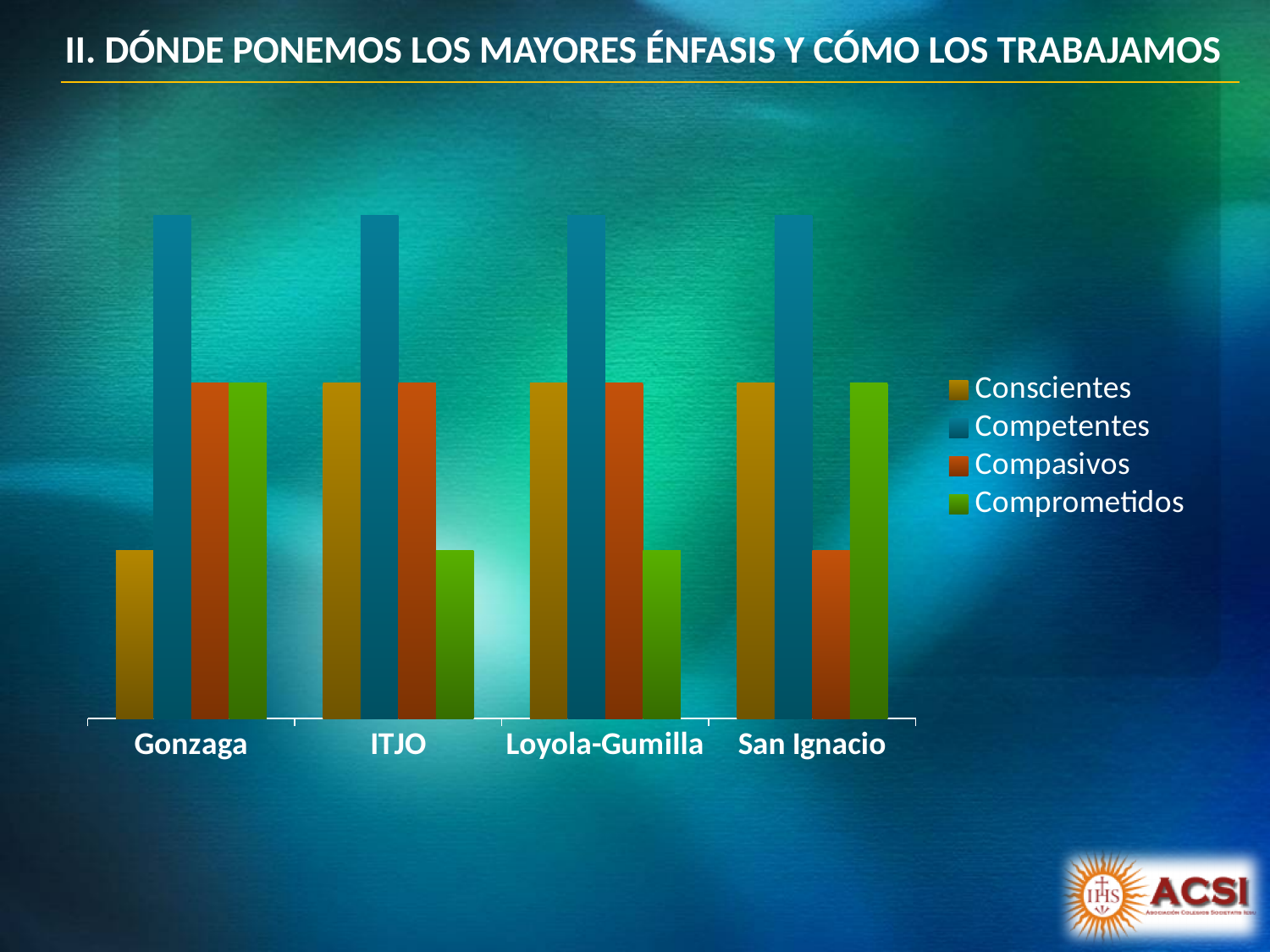
For Gonzaga, which is larger: the Conscientes bar or the Compasivos bar? Compasivos Which series has the lowest bar for ITJO? Comprometidos Which series has the lowest bar for Gonzaga? Conscientes What are the four series listed in the chart's legend? Conscientes, Competentes, Compasivos, Comprometidos Which series has the lowest bar for Loyola-Gumilla? Comprometidos What kind of chart is shown on the slide? Bar chart For San Ignacio, which is larger: the Compasivos bar or the Comprometidos bar? Comprometidos Which series has the tallest bar in every school shown? Competentes How many series does the chart's legend list? 4 How many schools (categories) are shown on the x axis of the chart? 4 Which series has the highest bar for Gonzaga? Competentes